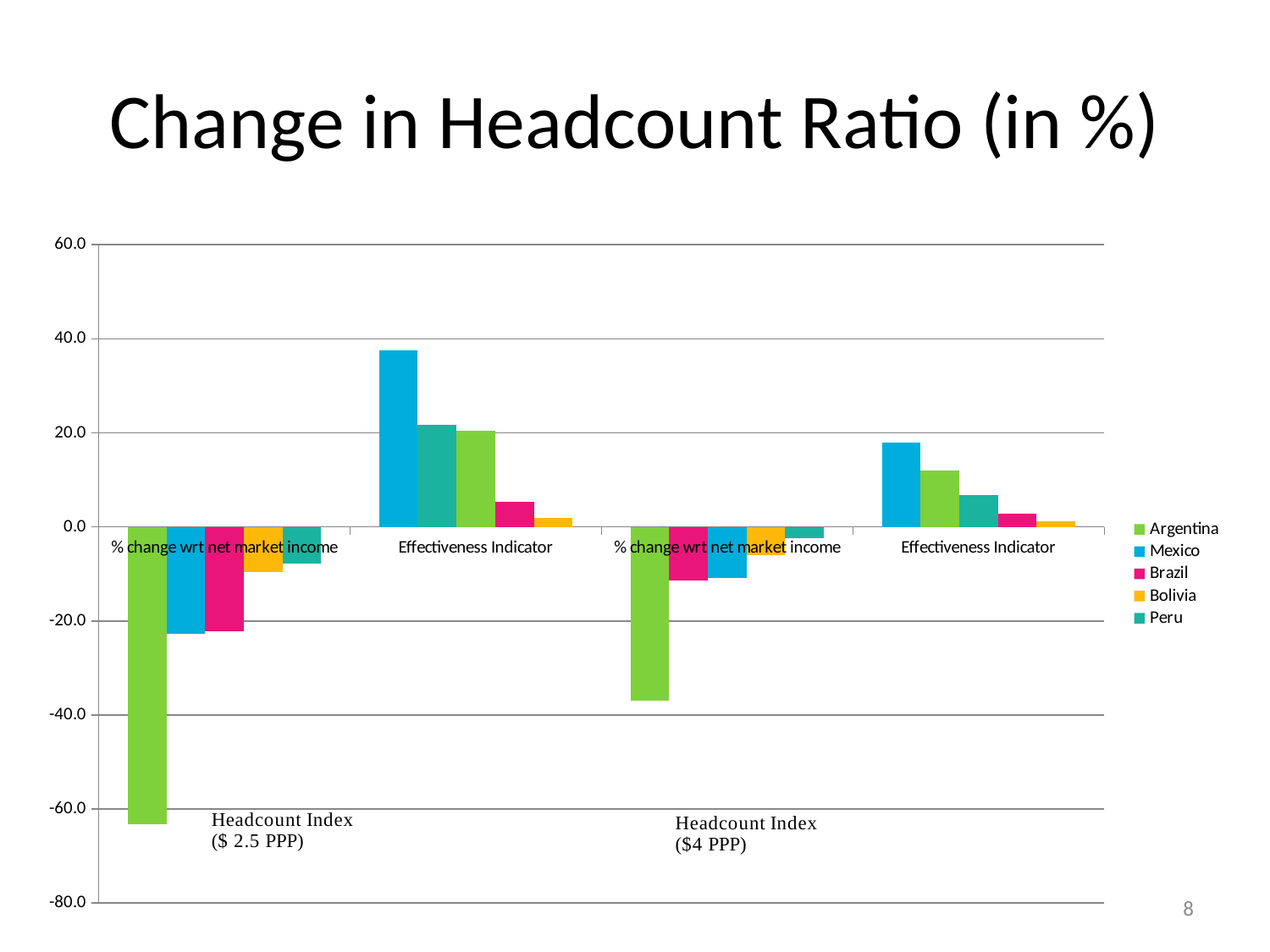
What is the title of the chart? Change in Headcount Ratio (in %) Which country has the highest Effectiveness Indicator for the Headcount Index ($ 2.5 PPP)? Mexico How many categories are shown along the x axis? 4 Is Mexico's Effectiveness Indicator for the Headcount Index ($ 2.5 PPP) greater or less than 20.0? greater How many series does the legend list? 5 What kind of chart is shown on the slide? bar chart For the Effectiveness Indicator of the Headcount Index ($4 PPP), which is larger: Mexico or Argentina? Mexico Which country has the highest Effectiveness Indicator for the Headcount Index ($4 PPP)? Mexico Is Argentina's % change wrt net market income for the Headcount Index ($4 PPP) greater or less than -20.0? less What colour represents Argentina in the legend? green Is Argentina's % change wrt net market income for the Headcount Index ($ 2.5 PPP) greater or less than -40.0? less Which country has the lowest (most negative) % change wrt net market income for the Headcount Index ($ 2.5 PPP)? Argentina